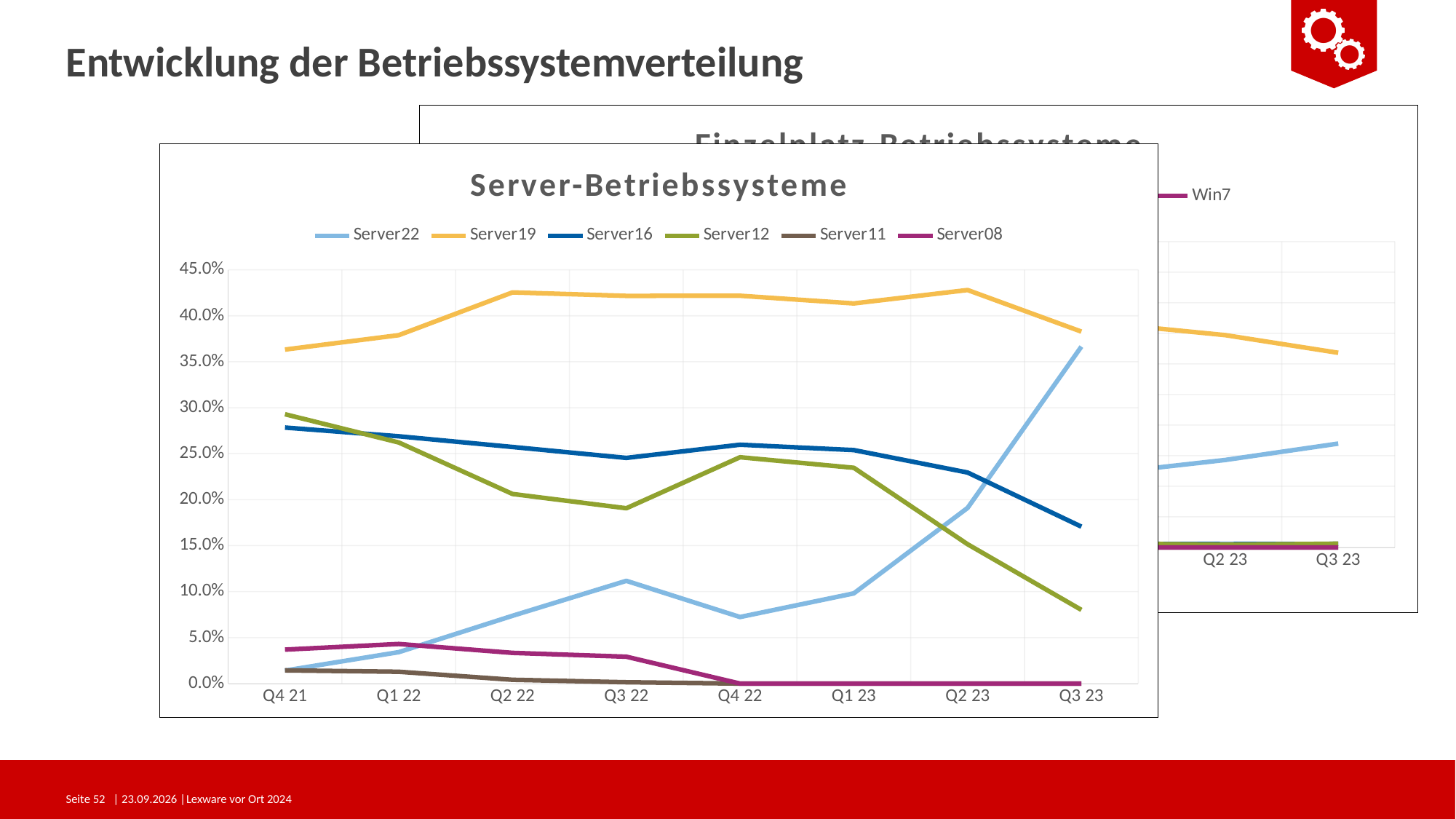
In the "Server-Betriebssysteme" chart, which series has the highest value at Q2 22? Server19 In the "Server-Betriebssysteme" chart, which is larger at Q1 22: Server08 or Server11? Server08 How many quarters are shown on the x axis of the "Server-Betriebssysteme" chart? 8 In the "Server-Betriebssysteme" chart, which is larger at Q3 22: Server16 or Server12? Server16 Which legend entry is visible on the partially hidden chart at the right of the slide? Win7 In the "Server-Betriebssysteme" chart, is the value for Server22 at Q3 23 greater or less than 30.0%? greater What kind of chart is the "Server-Betriebssysteme" chart? line chart In the "Server-Betriebssysteme" chart, does the Server22 line rise or fall from Q4 21 to Q3 23? rise How many series does the legend of the "Server-Betriebssysteme" chart list? 6 In the "Server-Betriebssysteme" chart, is the value for Server12 at Q3 23 greater or less than 10.0%? less In the "Server-Betriebssysteme" chart, which series has the lowest value at Q1 22? Server11 In the "Server-Betriebssysteme" chart, is the value for Server19 at Q2 22 greater or less than 40.0%? greater